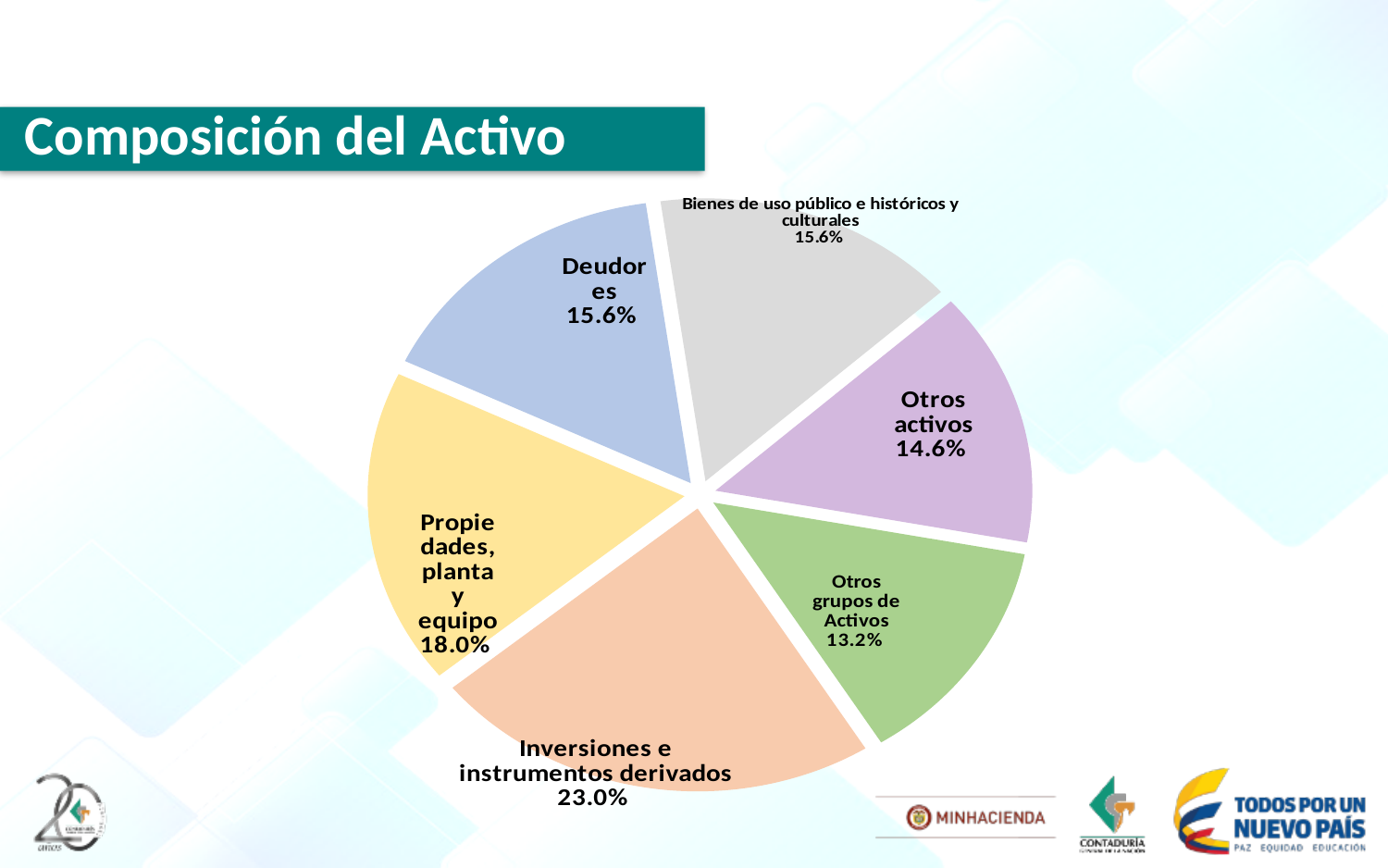
Which slice of the pie chart is the largest? Inversiones e instrumentos derivados What is the value shown for 'Propiedades, planta y equipo'? 18.0% What is the value shown for 'Otros grupos de Activos'? 13.2% What kind of chart is shown on the slide? Pie chart What is the value shown for 'Bienes de uso público e históricos y culturales'? 15.6% What is the difference between the shares of 'Deudores' and 'Otros activos'? 1.0% Which is larger, the share of 'Otros activos' or the share of 'Otros grupos de Activos'? Otros activos What share of the pie is 'Inversiones e instrumentos derivados'? 23.0% What is the difference between the shares of 'Inversiones e instrumentos derivados' and 'Propiedades, planta y equipo'? 5.0% What is the title of the slide's chart? Composición del Activo Which slice of the pie chart is the smallest? Otros grupos de Activos How many slices does the pie chart have? 6